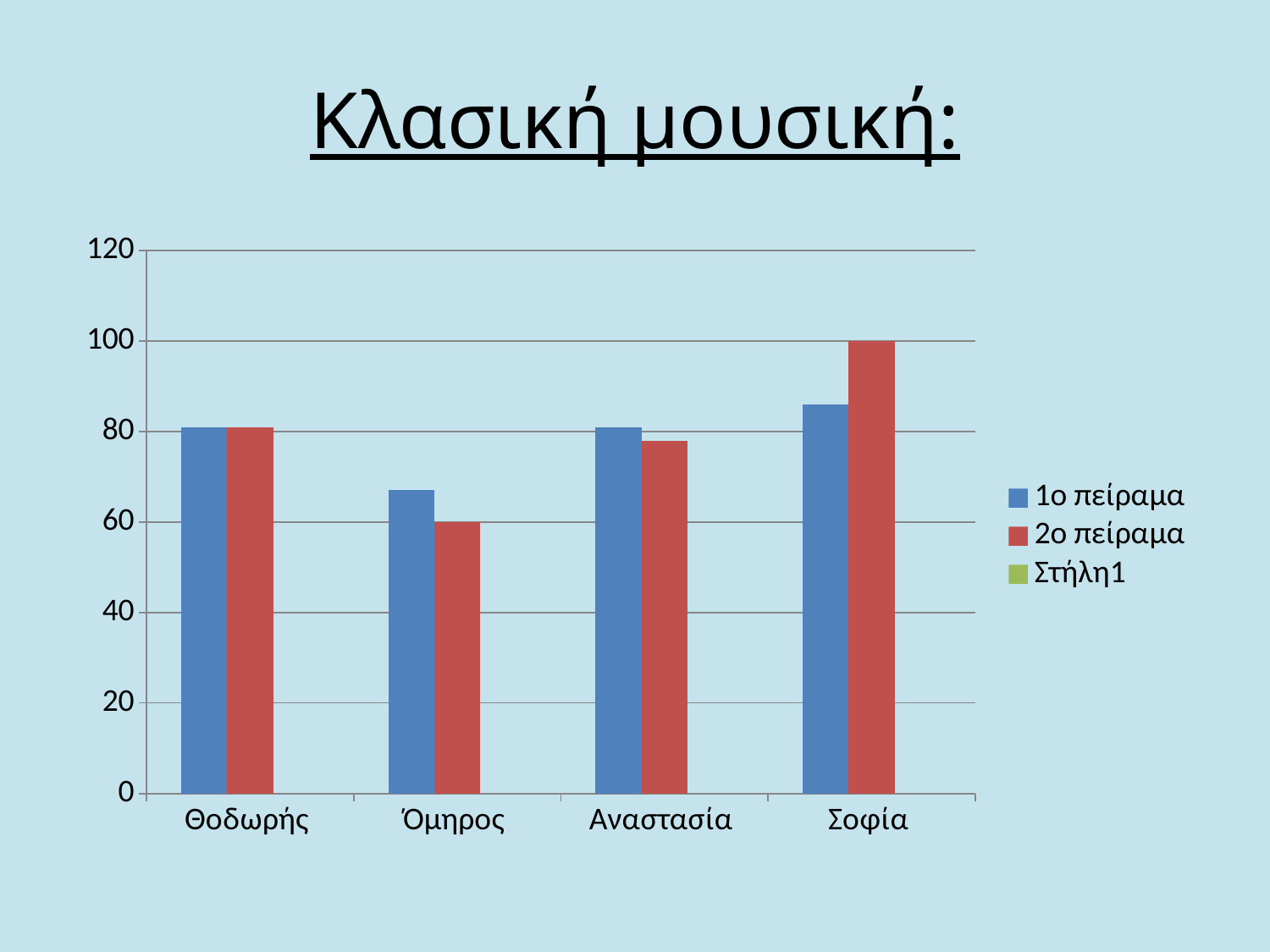
What kind of chart is shown on the slide? bar chart For Σοφία, which series has the larger value, 1ο πείραμα or 2ο πείραμα? 2ο πείραμα Which category has the highest value in the 2ο πείραμα series? Σοφία What is the value for Σοφία in the 2ο πείραμα series? 100 How many categories (names) are shown on the x axis of the chart? 4 For Όμηρος, which series has the larger value, 1ο πείραμα or 2ο πείραμα? 1ο πείραμα What is the title of the slide above the chart? Κλασική μουσική: Is the value for Σοφία in the 1ο πείραμα series greater or less than 80? greater How many series does the chart's legend list? 3 Which category has the lowest value in the 1ο πείραμα series? Όμηρος Is the value for Αναστασία in the 2ο πείραμα series greater or less than 60? greater What is the value for Όμηρος in the 2ο πείραμα series? 60